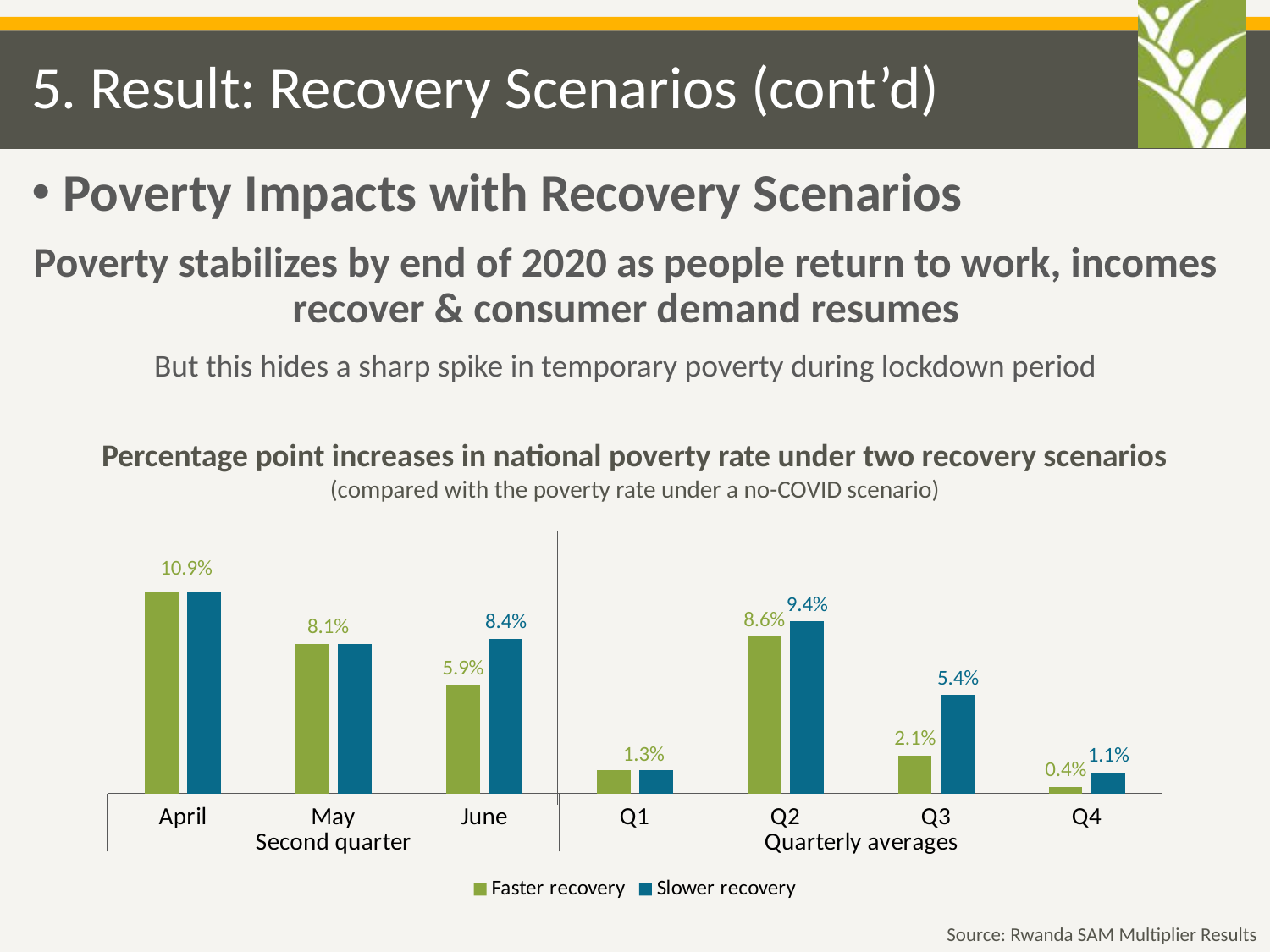
What is the value for Slower recovery in June? 8.4% What is the difference between the Slower recovery and Faster recovery values in Q3? 3.3% Do the Faster recovery values rise or fall from April to June? Fall What is the value for Faster recovery in Q3? 2.1% In June, which series has the larger value, Faster recovery or Slower recovery? Slower recovery Which category has the lowest value for Slower recovery? Q4 What kind of chart is shown on the slide? Bar chart What is the value for Slower recovery in Q2? 9.4% Which category has the highest value for Faster recovery? April How many categories are shown on the x axis of the chart? 7 What is the value for Faster recovery in Q4? 0.4% How many series does the legend list? 2